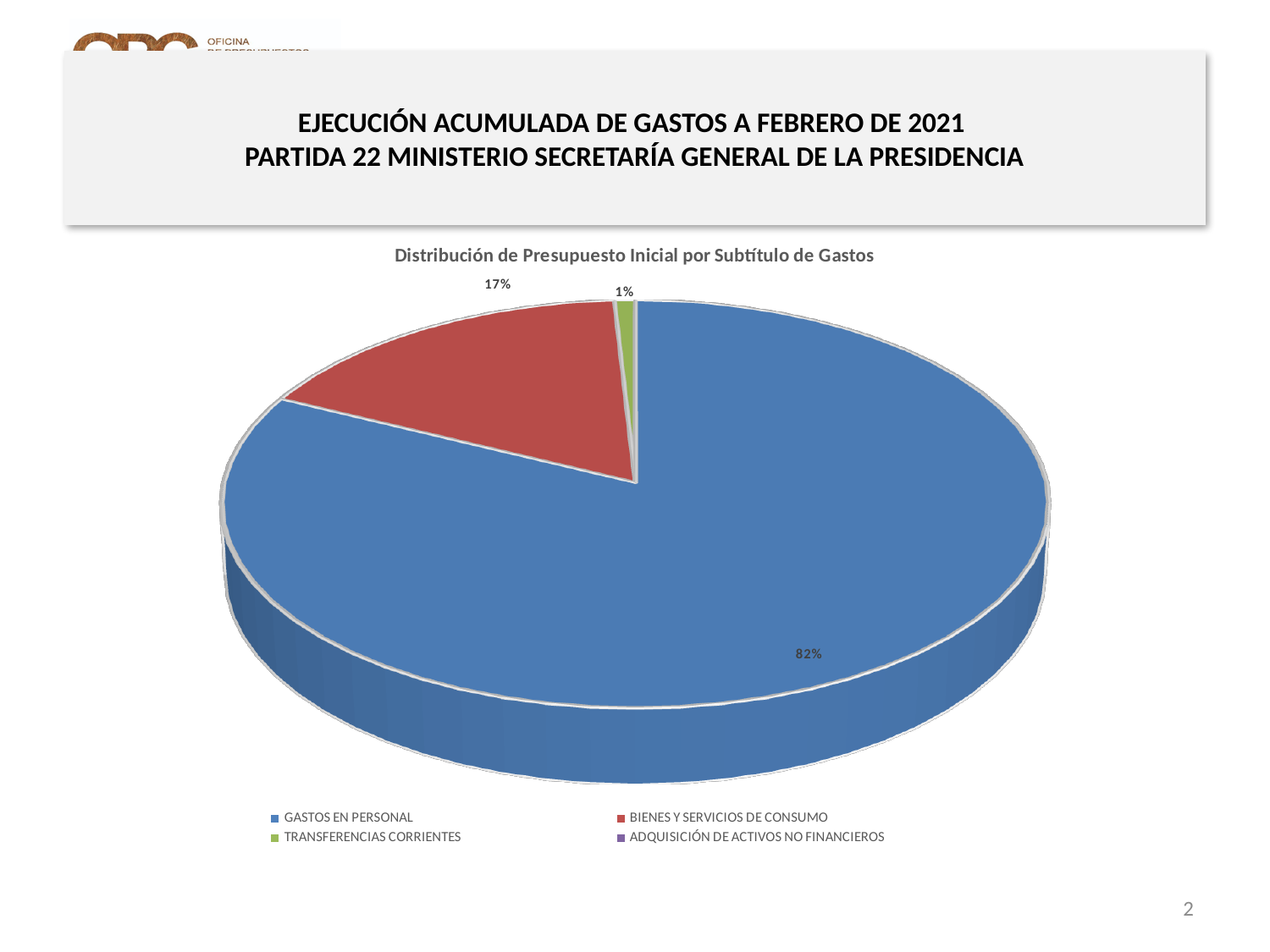
Which of the labelled slices is the smallest? TRANSFERENCIAS CORRIENTES What share of the pie does BIENES Y SERVICIOS DE CONSUMO represent? 17% What colour is the GASTOS EN PERSONAL slice? Blue What kind of chart is shown on the slide? Pie chart Which is larger, the BIENES Y SERVICIOS DE CONSUMO slice or the TRANSFERENCIAS CORRIENTES slice? BIENES Y SERVICIOS DE CONSUMO What share of the pie does GASTOS EN PERSONAL represent? 82% What share of the pie does TRANSFERENCIAS CORRIENTES represent? 1% How many categories does the legend list? 4 What is the title of the chart? Distribución de Presupuesto Inicial por Subtítulo de Gastos How many slices have a percentage label printed on the chart? 3 What is the difference in percentage points between the GASTOS EN PERSONAL slice and the BIENES Y SERVICIOS DE CONSUMO slice? 65 percentage points Which category has the largest slice of the pie? GASTOS EN PERSONAL